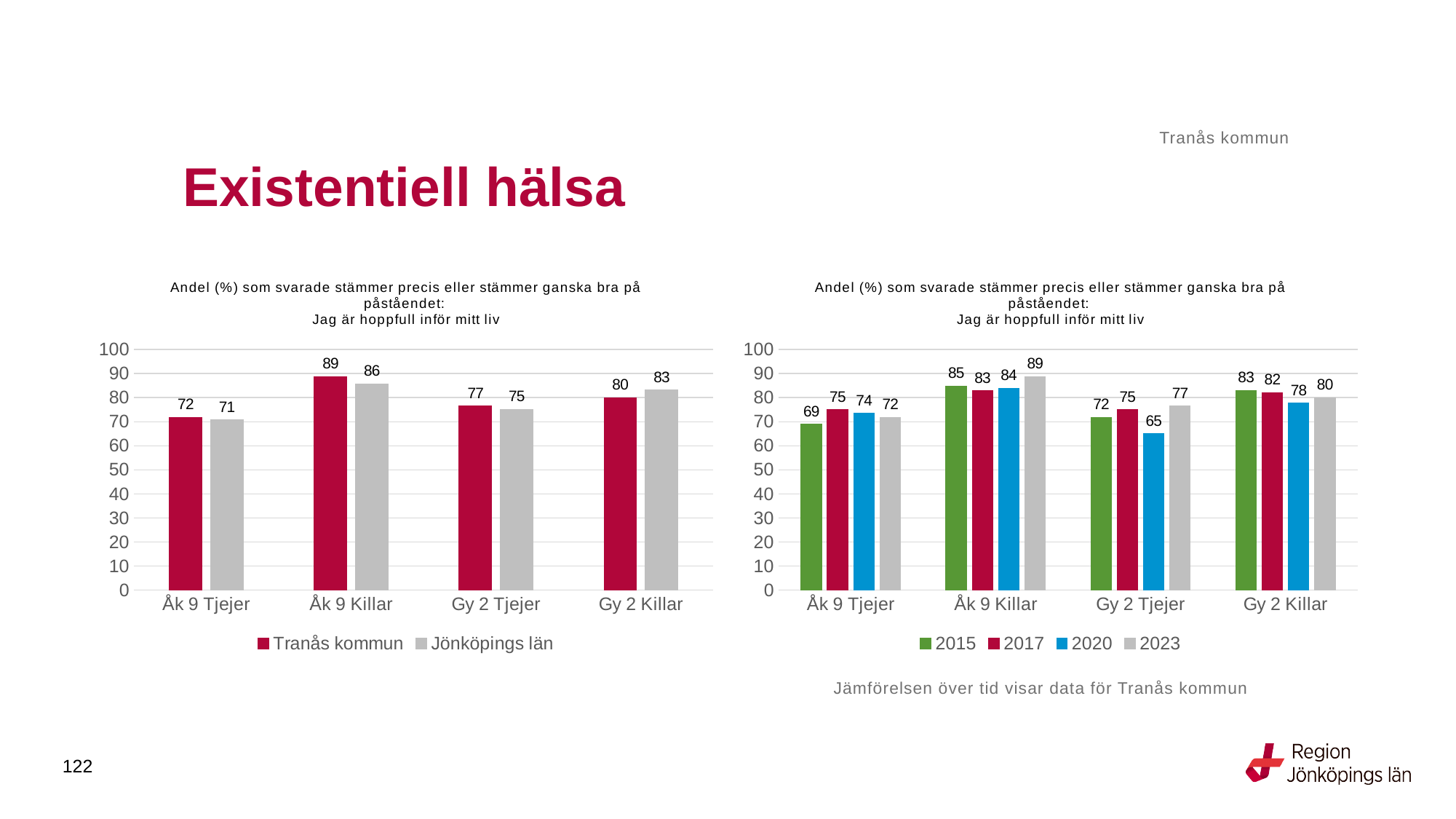
In the right chart, what is the difference between the 2023 and 2020 values for Gy 2 Tjejer? 12 In the left chart, how many series does the legend list? 2 In the left chart, which category has the lowest value for Jönköpings län? Åk 9 Tjejer In the left chart, what is the value for Tranås kommun for Åk 9 Killar? 89 In the left chart, which category has the highest value for Tranås kommun? Åk 9 Killar What type of chart is the right chart? Bar chart In the left chart, what is the difference between Tranås kommun and Jönköpings län for Gy 2 Killar? 3 In the right chart, which year has the highest value for Åk 9 Killar? 2023 In the right chart, what is the value for 2015 for Åk 9 Tjejer? 69 In the right chart, what is the value for 2020 for Gy 2 Tjejer? 65 In the left chart, what is the value for Jönköpings län for Gy 2 Tjejer? 75 In the right chart, which is larger for Gy 2 Killar: 2015 or 2020? 2015